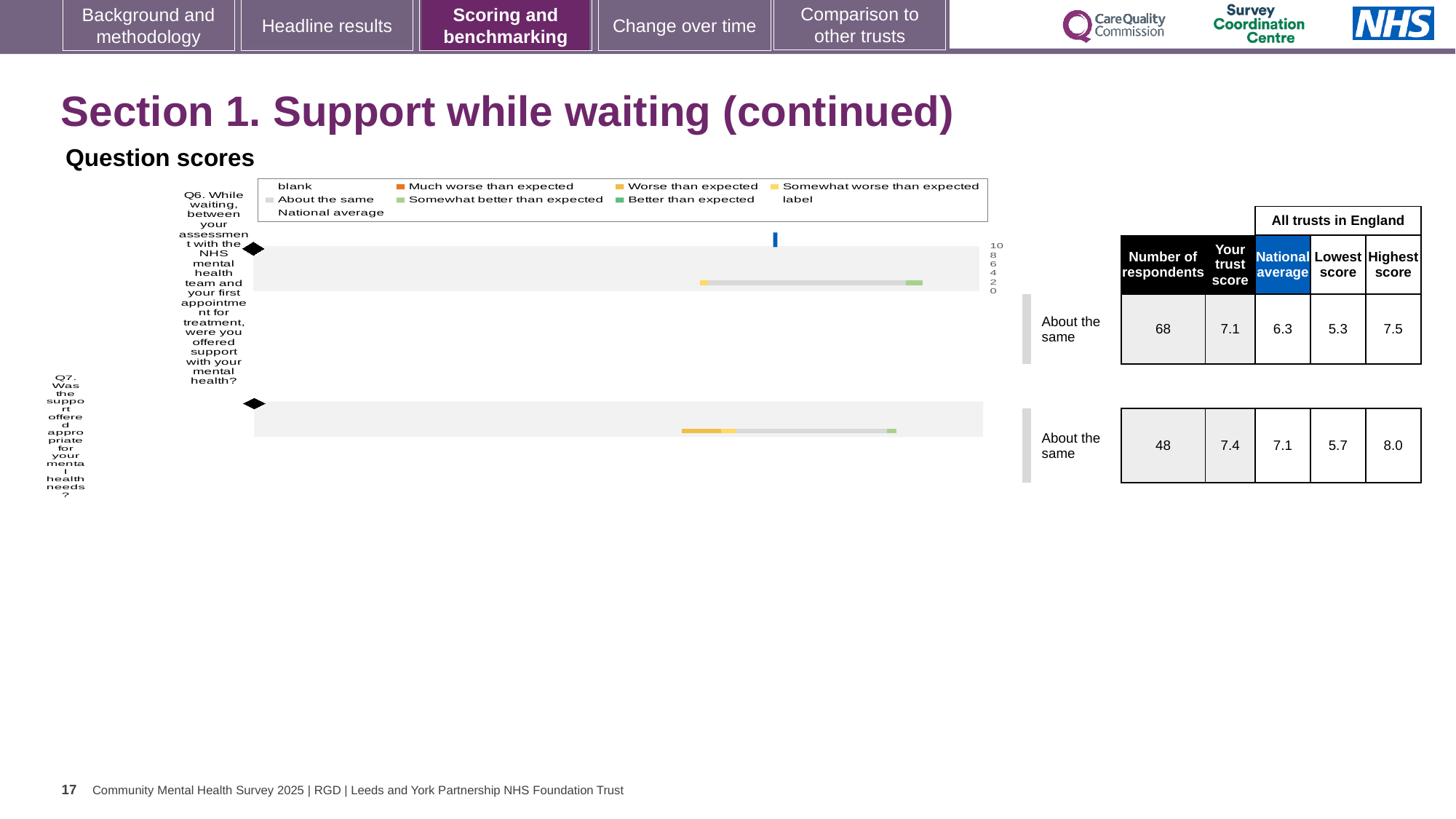
What is the 'Your trust score' for Q6 (While waiting, between your assessment with the NHS mental health team and your first appointment for treatment, were you offered support with your mental health?)? 7.1 What is the national average score for Q7 (Was the support offered appropriate for your mental health needs?)? 7.1 What benchmark category is shown for both Q6 and Q7? About the same What is the lowest score among all trusts in England for Q6? 5.3 By how much does the trust score for Q7 exceed the national average for Q7? 0.3 What is the highest score among all trusts in England for Q7? 8.0 What kind of chart is used to show the question scores? Bar chart What is the difference between the highest and lowest scores for Q6? 2.2 Which question has the higher 'Your trust score', Q6 or Q7? Q7 How many respondents answered Q6? 68 What is the heading above the chart? Question scores How many questions are plotted on the chart? 2